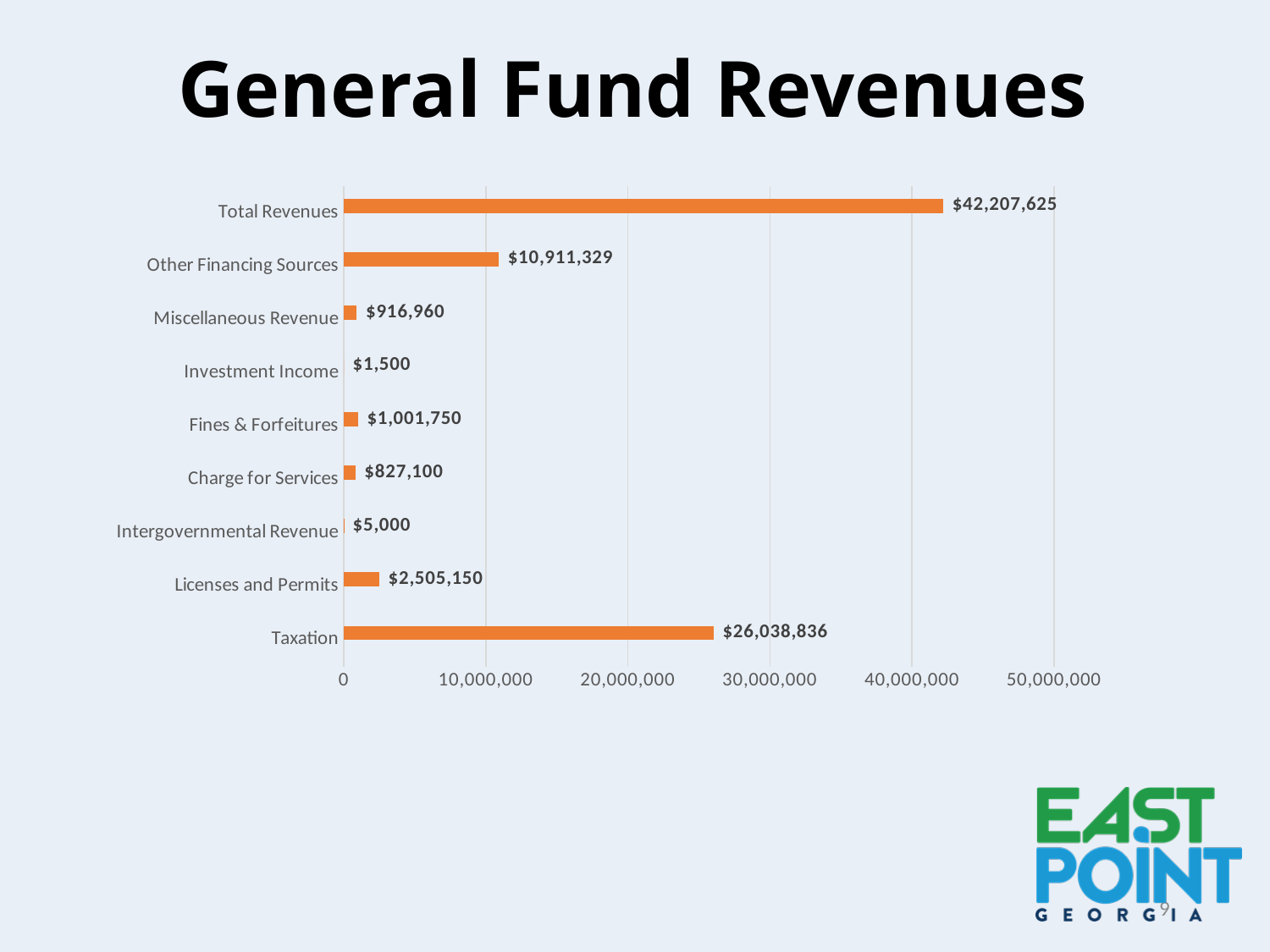
What is the value for Other Financing Sources? $10,911,329 Which category has the lowest value? Investment Income Is the value for Taxation greater or less than 20,000,000? greater What is the value for Licenses and Permits? $2,505,150 What is the difference between Fines & Forfeitures and Miscellaneous Revenue? $84,790 Which category has the highest value? Total Revenues What is the difference between Taxation and Licenses and Permits? $23,533,686 How many categories are shown in the chart? 9 What is the value for Intergovernmental Revenue? $5,000 What is the value for Taxation? $26,038,836 Which is larger, Charge for Services or Miscellaneous Revenue? Miscellaneous Revenue What kind of chart is shown on the slide? bar chart